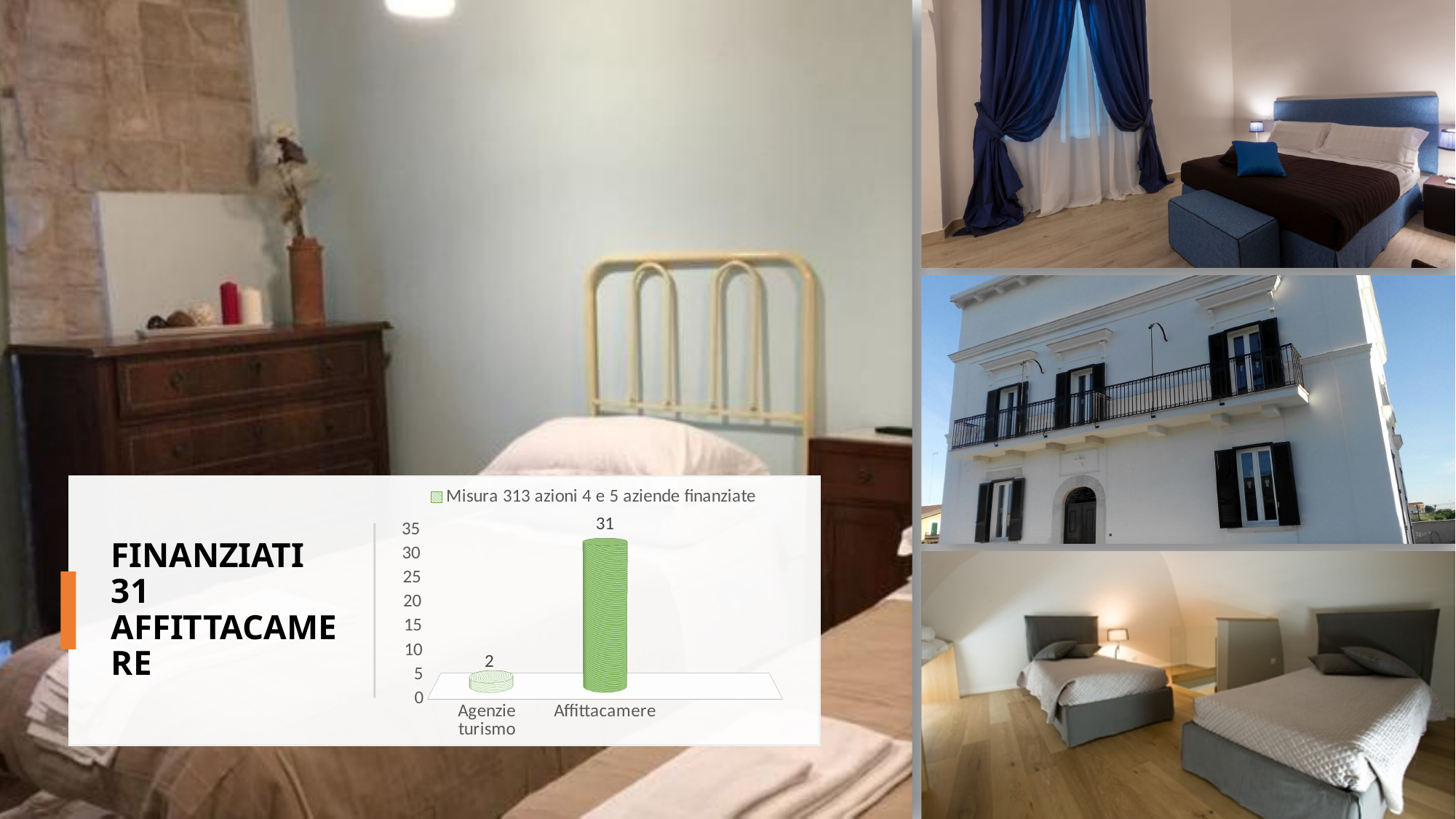
What kind of chart is shown? bar chart Which category has the highest value? Affittacamere What is the legend entry of the series shown in the chart? Misura 313 azioni 4 e 5 aziende finanziate Is the value for Agenzie turismo greater or less than 5? less Which is larger, the value for Agenzie turismo or the value for Affittacamere? Affittacamere What is the difference between the values for Affittacamere and Agenzie turismo? 29 What is the value for Agenzie turismo? 2 How many series does the legend list? 1 How many categories are shown on the x axis? 2 Is the value for Affittacamere greater or less than 20? greater Which category has the lowest value? Agenzie turismo What is the value for Affittacamere? 31